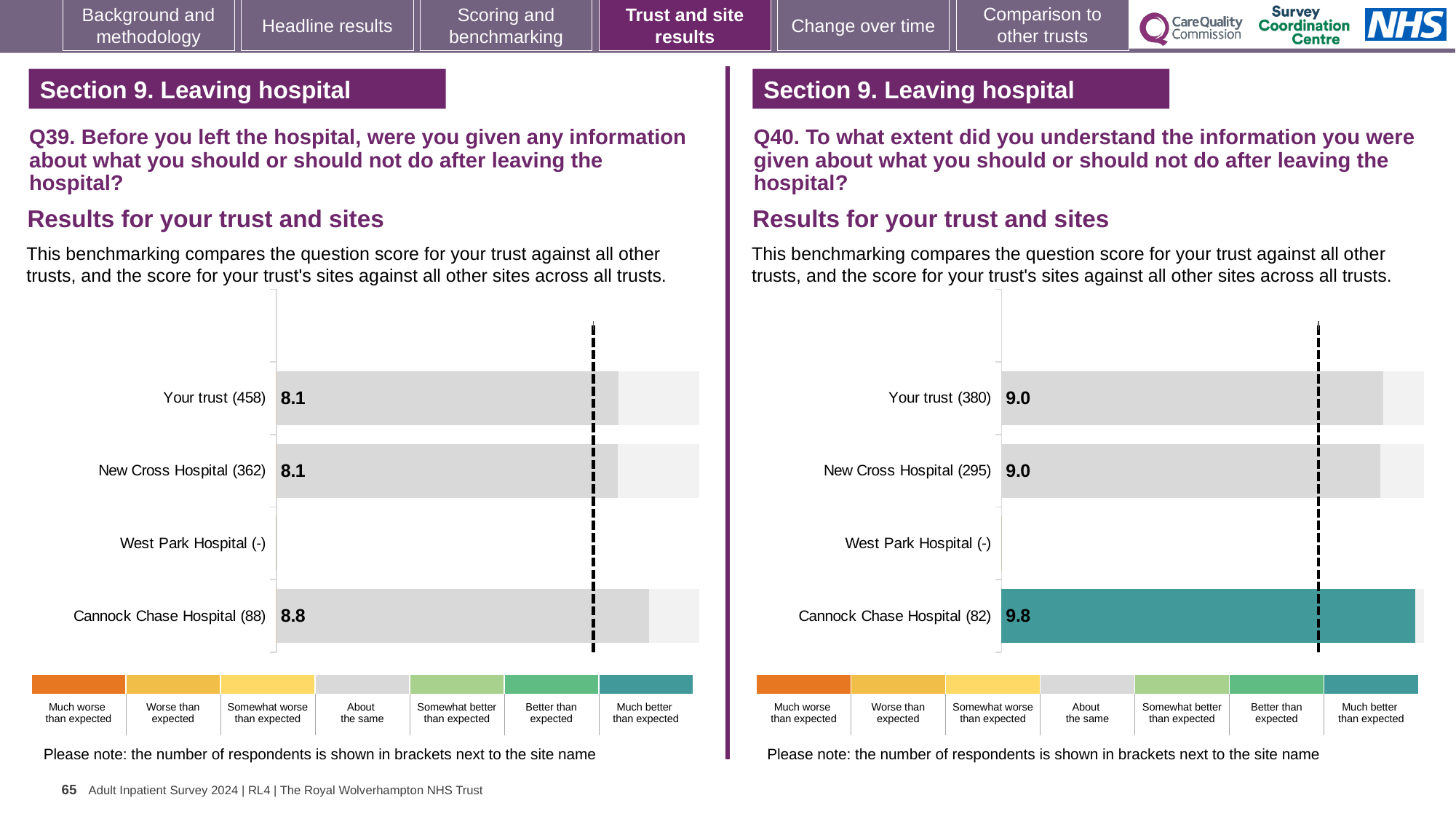
In the Q39 chart on the left, what is the score for Cannock Chase Hospital? 8.8 In the Q40 chart on the right, which has a larger score, Your trust or Cannock Chase Hospital? Cannock Chase Hospital How many categories (rows) are listed in the Q39 chart on the left? 4 In the Q40 chart on the right, how many respondents are shown in brackets for Your trust? 380 In the Q40 chart on the right, what is the score for Cannock Chase Hospital? 9.8 In the Q39 chart on the left, which site has the highest score? Cannock Chase Hospital In the Q39 chart on the left, what is the difference between the Cannock Chase Hospital score and the Your trust score? 0.7 In the Q39 chart on the left, what is the score for Your trust? 8.1 In the Q40 chart on the right, which site has the highest score? Cannock Chase Hospital In the Q40 chart on the right, what is the score for New Cross Hospital? 9.0 In the Q40 chart on the right, what is the difference between the Cannock Chase Hospital score and the New Cross Hospital score? 0.8 What type of chart is used in the Q40 chart on the right? Bar chart